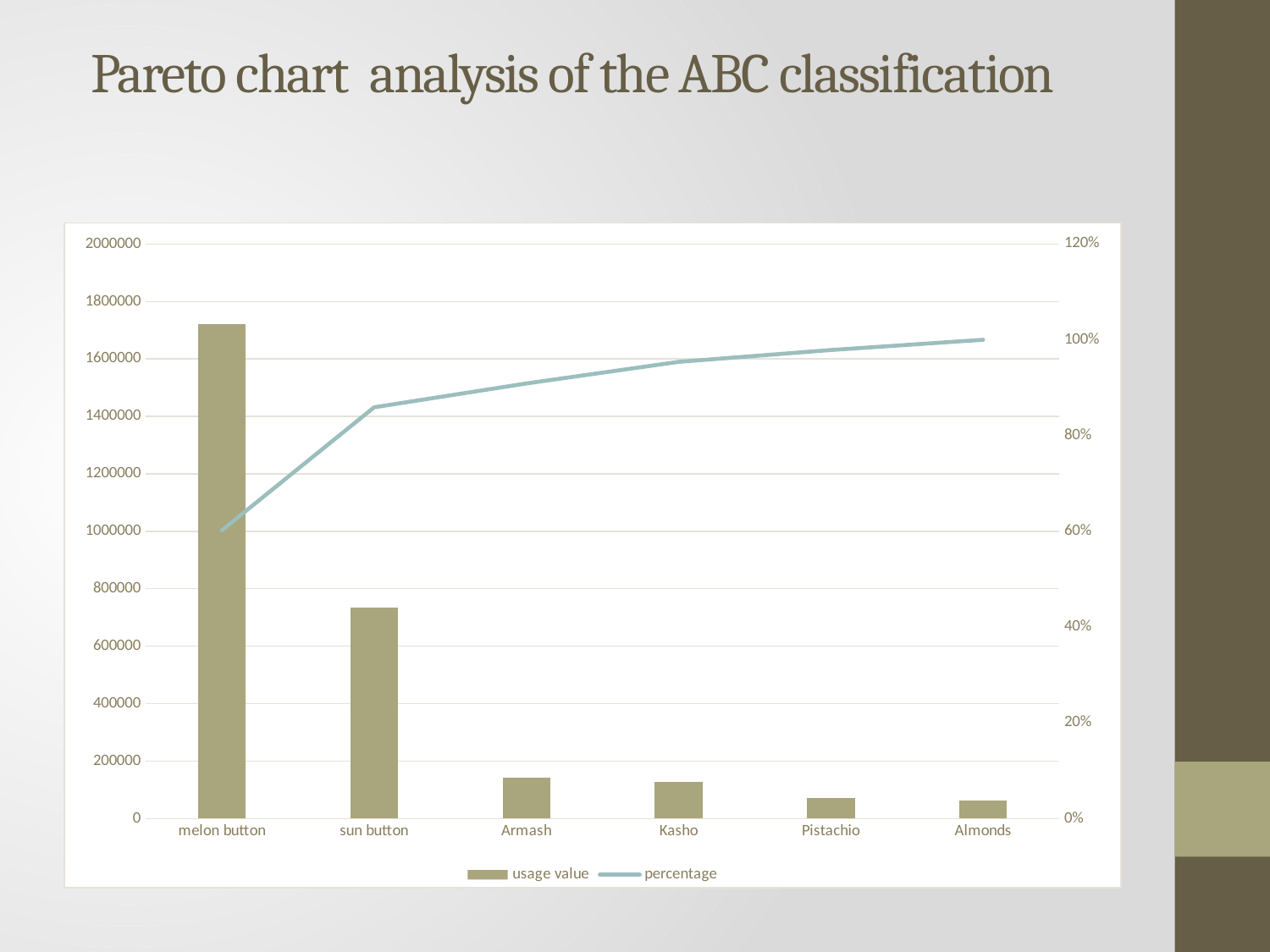
Is the usage value for sun button greater or less than 800000? less How many categories are shown on the x axis of the chart? 6 How many series does the chart's legend list? 2 Which is larger, the usage value for melon button or for sun button? melon button What kind of chart is shown on the slide? A combined bar and line chart Which category has the highest usage value bar? melon button Is the percentage value for melon button greater or less than 80%? less Is the percentage value for sun button greater or less than 80%? greater Does the percentage line rise or fall from melon button to Almonds? rise What are the two series named in the chart's legend? usage value and percentage